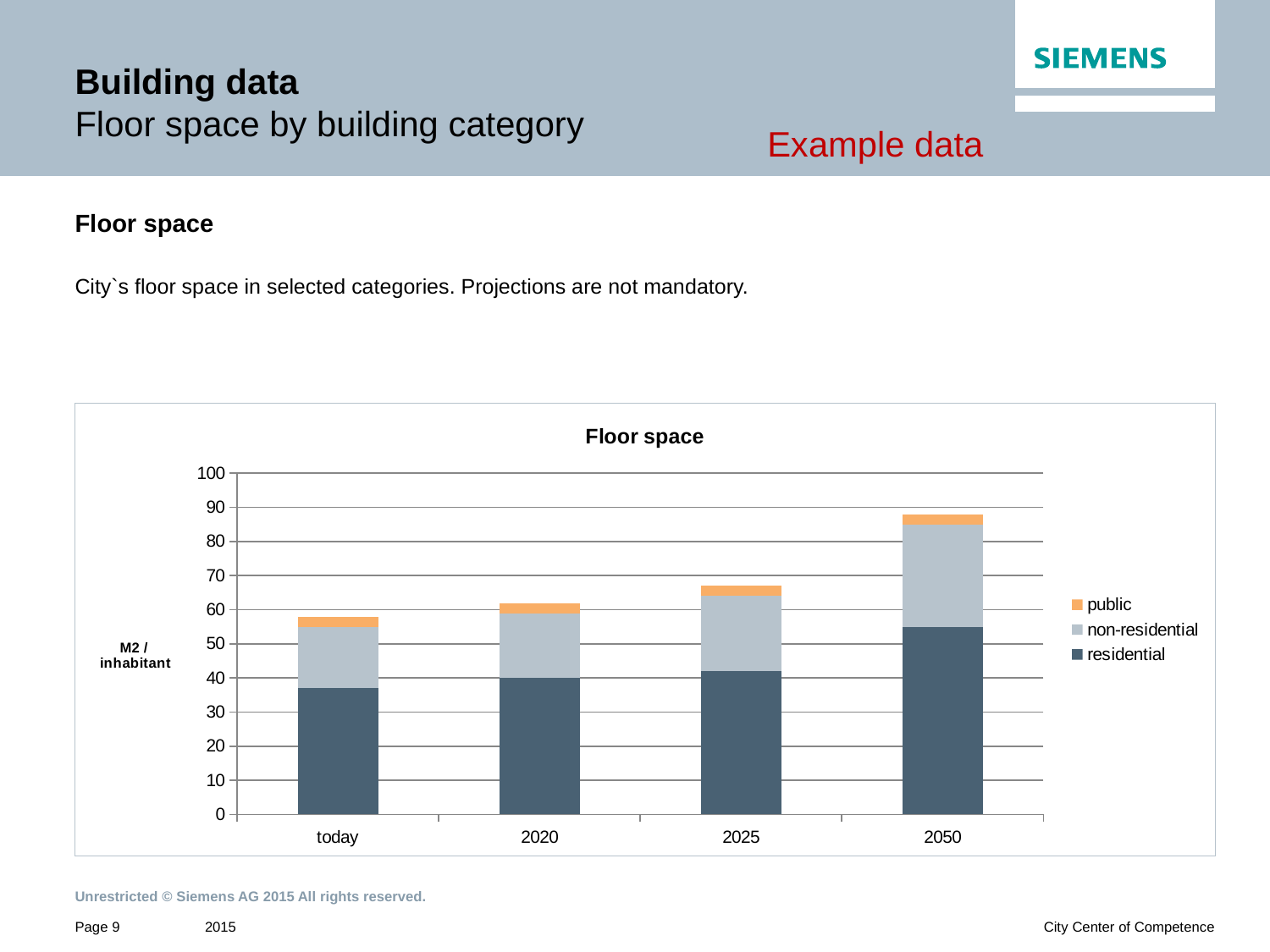
What kind of chart is shown on the slide? stacked bar chart Is the total floor space for 2025 greater or less than 70? less Which category has the highest total floor space? 2050 Which category has the lowest total floor space? today What is the title of the chart? Floor space Which is larger, the residential value for 2050 or the residential value for 2025? 2050 Is the total floor space for 2050 greater or less than 80? greater How many categories are shown on the x axis? 4 How many series does the legend list? 3 Is the residential value for 2050 greater or less than 50? greater Do the total floor space values rise or fall from today to 2050? rise